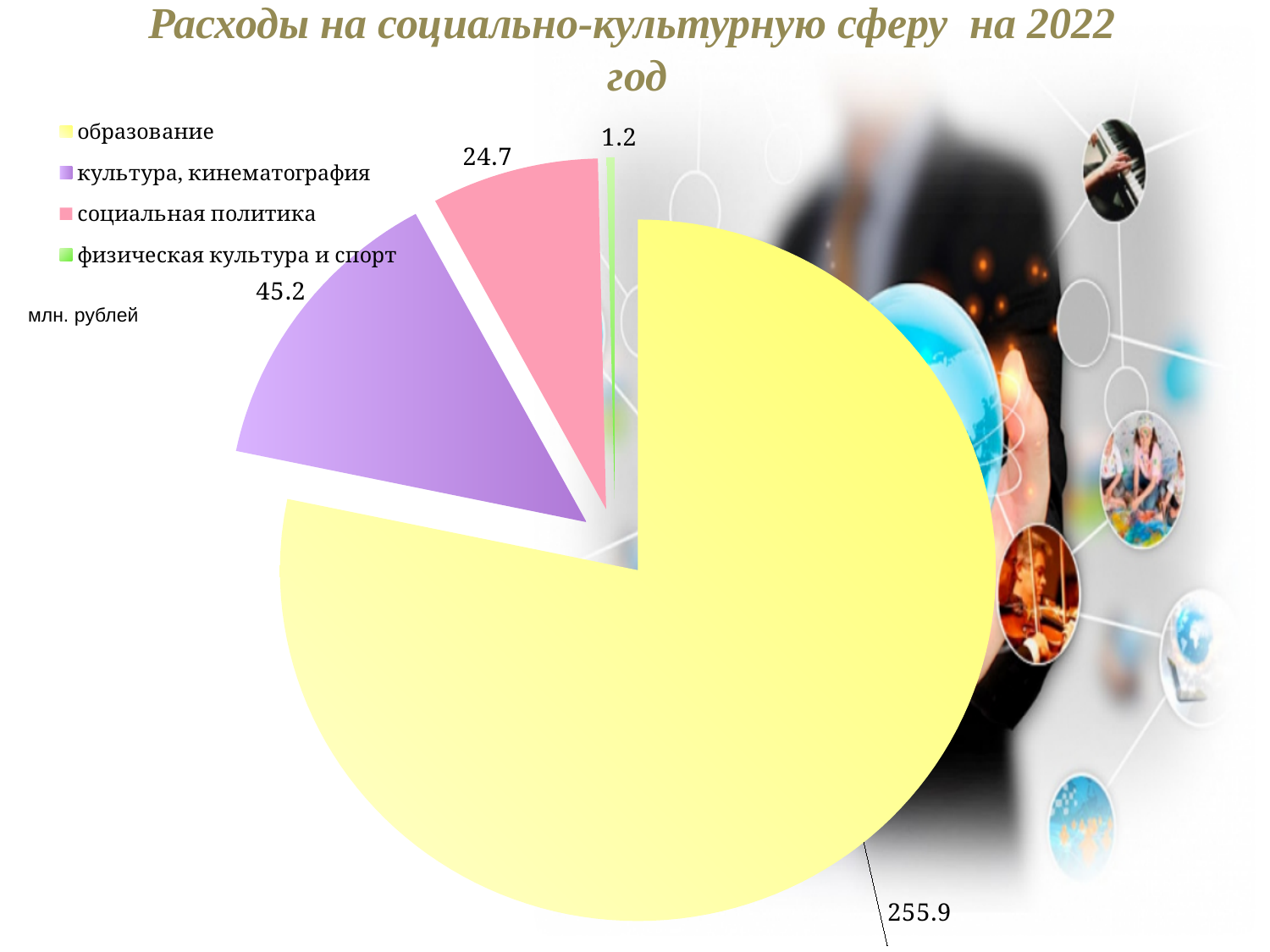
How many categories does the pie chart show? 4 What is the value for социальная политика? 24.7 What is the difference between the values for культура, кинематография and социальная политика? 20.5 Which is larger, the value for социальная политика or the value for физическая культура и спорт? социальная политика What unit is stated for the values on the chart? млн. рублей Which category has the smallest slice of the pie? физическая культура и спорт What is the difference between the values for образование and культура, кинематография? 210.7 What is the value for образование? 255.9 Which category has the largest slice of the pie? образование What type of chart is shown on the slide? pie chart What is the value for физическая культура и спорт? 1.2 What is the value for культура, кинематография? 45.2